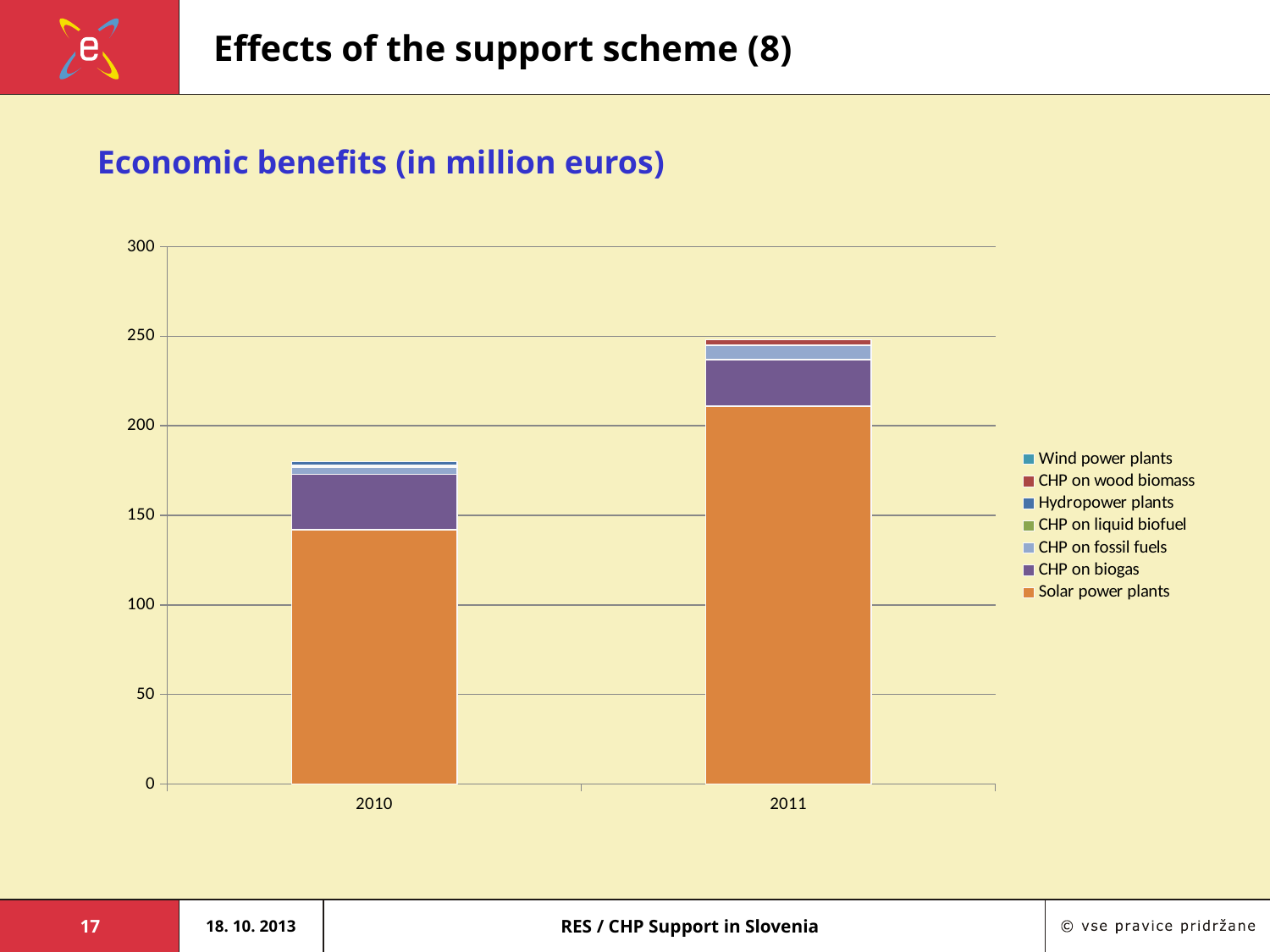
Which year has the taller stacked bar, 2010 or 2011? 2011 Do the total economic benefits rise or fall from 2010 to 2011? rise Is the value for Solar power plants in 2011 greater or less than 200? greater How many series does the chart's legend list? 7 What is the title of the chart? Economic benefits (in million euros) Which series forms the largest segment of the stacked bars in both years? Solar power plants Is the total stacked bar for 2010 greater or less than 200? less Is the value for Solar power plants in 2010 greater or less than 150? less How many years are shown on the x axis of the chart? 2 What kind of chart is shown on the slide? stacked bar chart